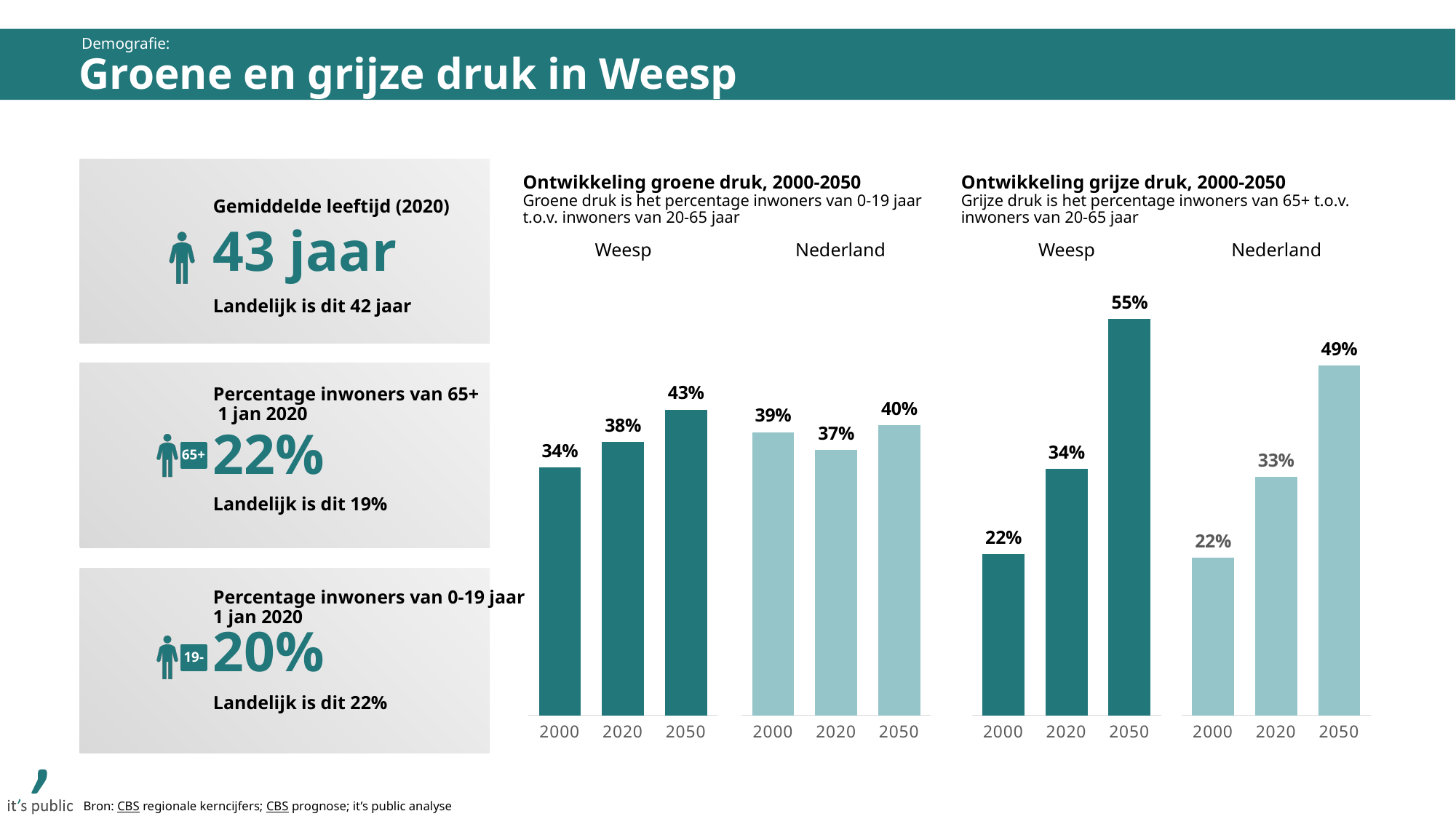
In the 'Ontwikkeling grijze druk, 2000-2050' chart, what is the difference between Weesp and Nederland in 2050? 6% In the 'Ontwikkeling groene druk, 2000-2050' chart, what is the difference between Weesp 2050 and Weesp 2000? 9% In the 'Ontwikkeling groene druk, 2000-2050' chart, which Weesp year has the lowest value? 2000 What type of chart is 'Ontwikkeling groene druk, 2000-2050'? bar chart In the 'Ontwikkeling grijze druk, 2000-2050' chart, which bar is the highest? Weesp 2050 In the 'Ontwikkeling grijze druk, 2000-2050' chart, what is the value for Weesp in 2050? 55% In the 'Ontwikkeling grijze druk, 2000-2050' chart, what is the value for Nederland in 2000? 22% In the 'Ontwikkeling groene druk, 2000-2050' chart, what is the value for Nederland in 2020? 37% How many bars are shown in the 'Ontwikkeling grijze druk, 2000-2050' chart? 6 In the 'Ontwikkeling groene druk, 2000-2050' chart, which is larger in 2000: Weesp or Nederland? Nederland In the 'Ontwikkeling groene druk, 2000-2050' chart, what is the value for Weesp in 2050? 43% In the 'Ontwikkeling grijze druk, 2000-2050' chart, do the Weesp values rise or fall from 2000 to 2050? rise